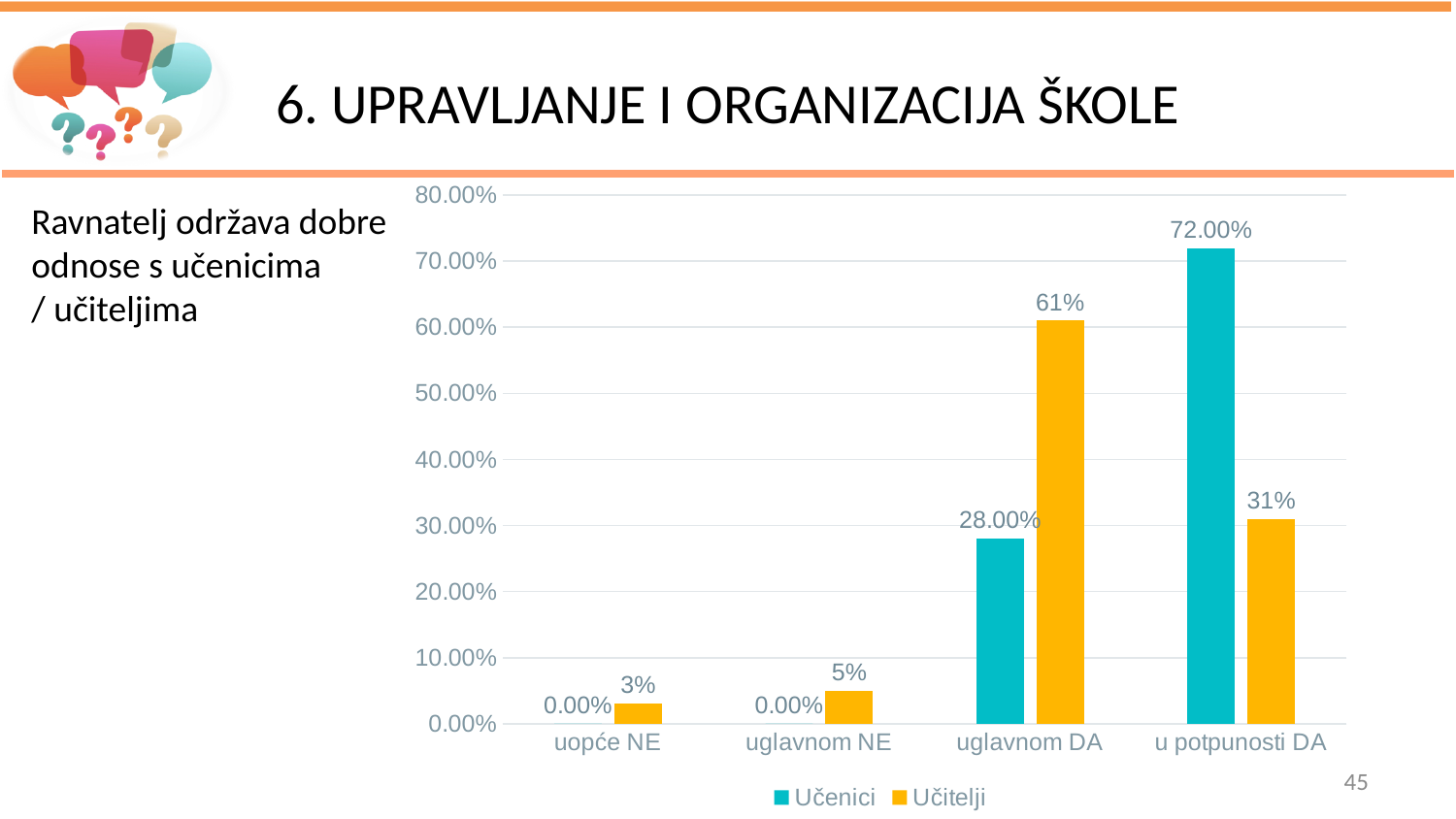
Which category has the lowest value for Učitelji? uopće NE How many series does the legend list? 2 What is the value for Učitelji in the 'uglavnom DA' category? 61% How many categories are shown on the x axis? 4 What is the difference between the Učitelji values for 'uglavnom DA' and 'u potpunosti DA'? 30% What is the value for Učenici in the 'u potpunosti DA' category? 72.00% Which is larger in the 'uglavnom DA' category: Učenici or Učitelji? Učitelji What is the value for Učitelji in the 'uopće NE' category? 3% What is the value for Učenici in the 'uglavnom NE' category? 0.00% Which colour represents the Učitelji series? yellow Which category has the highest value for Učenici? u potpunosti DA What kind of chart is shown on the slide? bar chart